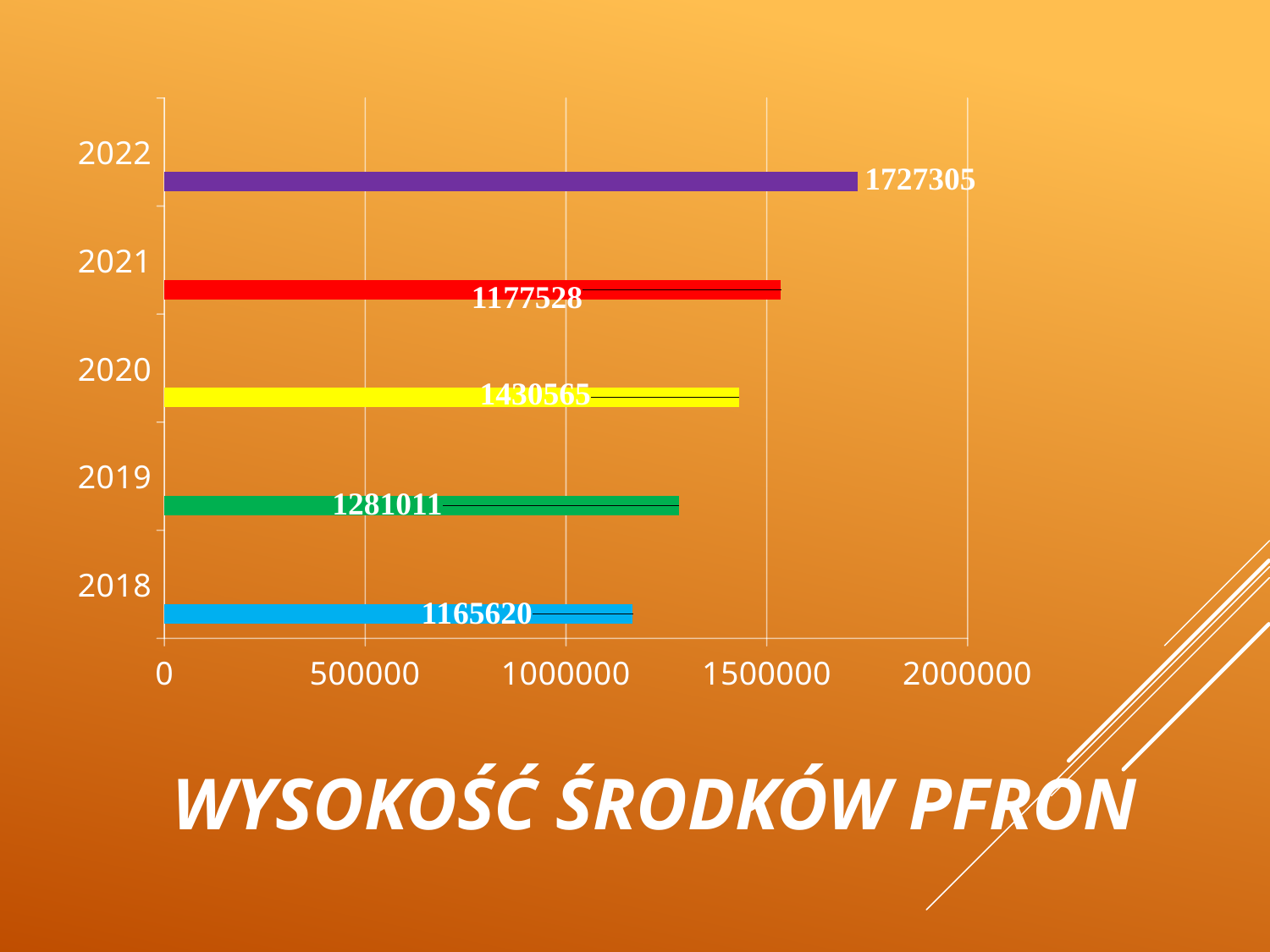
Which is larger, the value for 2020 or the value for 2019? 2020 How many years are shown on the chart? 5 What is the value for 2019? 1281011 What is the difference between the values for 2020 and 2019? 149554 Is the value for 2019 greater or less than 1000000? greater What is the value for 2020? 1430565 What is the difference between the values for 2022 and 2020? 296740 What is the value for 2018? 1165620 Which year has the highest value? 2022 What kind of chart is shown on the slide? bar chart What is the value for 2022? 1727305 What is the title of the chart? WYSOKOŚĆ ŚRODKÓW PFRON